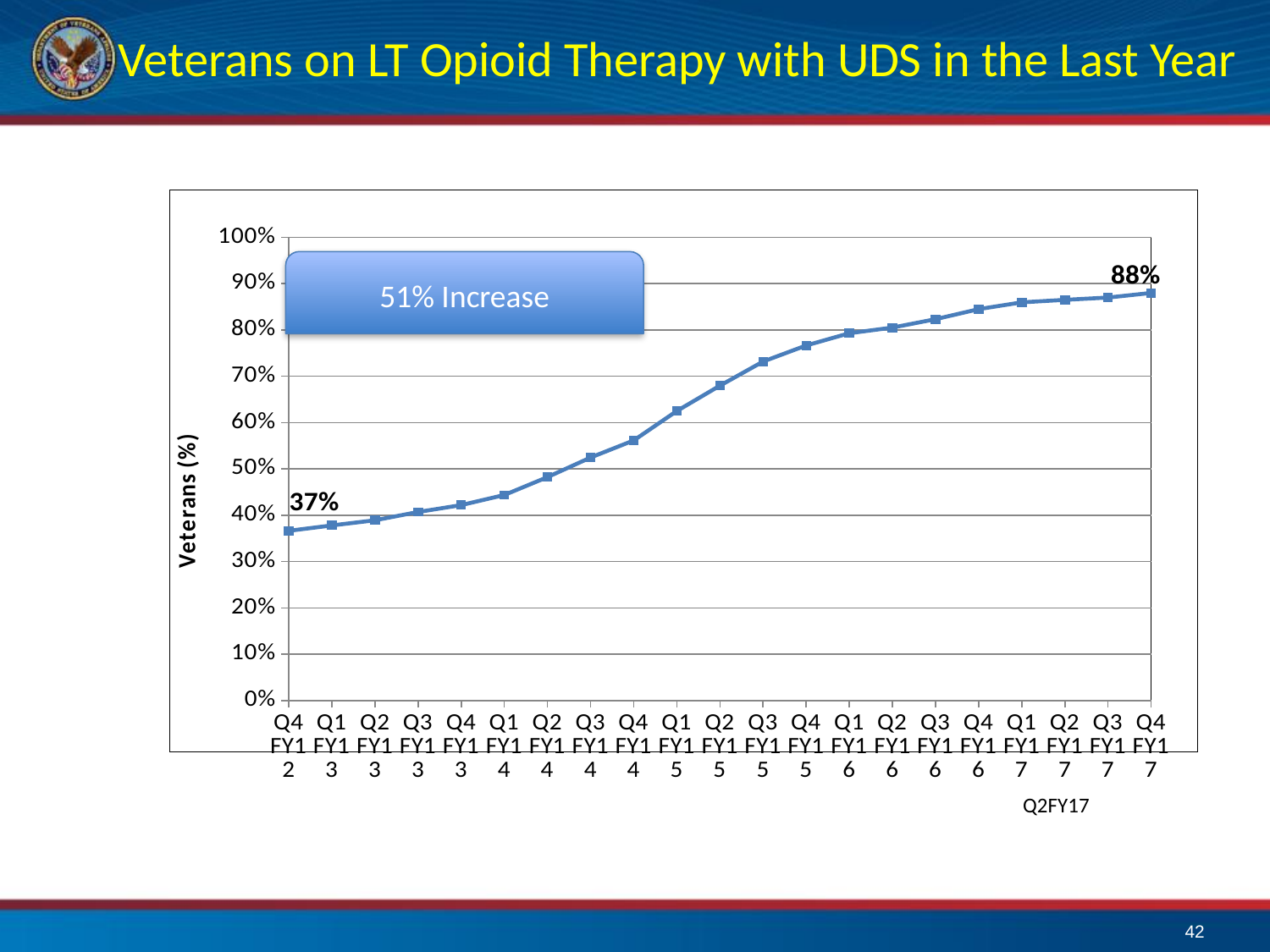
Is the value for Q1 FY14 greater or less than 50%? less Which quarter has the lowest value? Q4 FY12 What kind of chart is shown on the slide? Line chart Do the values rise or fall from Q4 FY12 to Q4 FY17? Rise Is the value for Q2 FY15 greater or less than 60%? greater Which quarter has the highest value? Q4 FY17 What is the value for Q4 FY12? 37% What is the difference between the values for Q4 FY17 and Q4 FY12? 51% Which is larger, the value for Q4 FY17 or the value for Q4 FY12? Q4 FY17 How many quarters are plotted on the x axis? 21 What is the label on the y axis? Veterans (%) What is the value for Q4 FY17? 88%